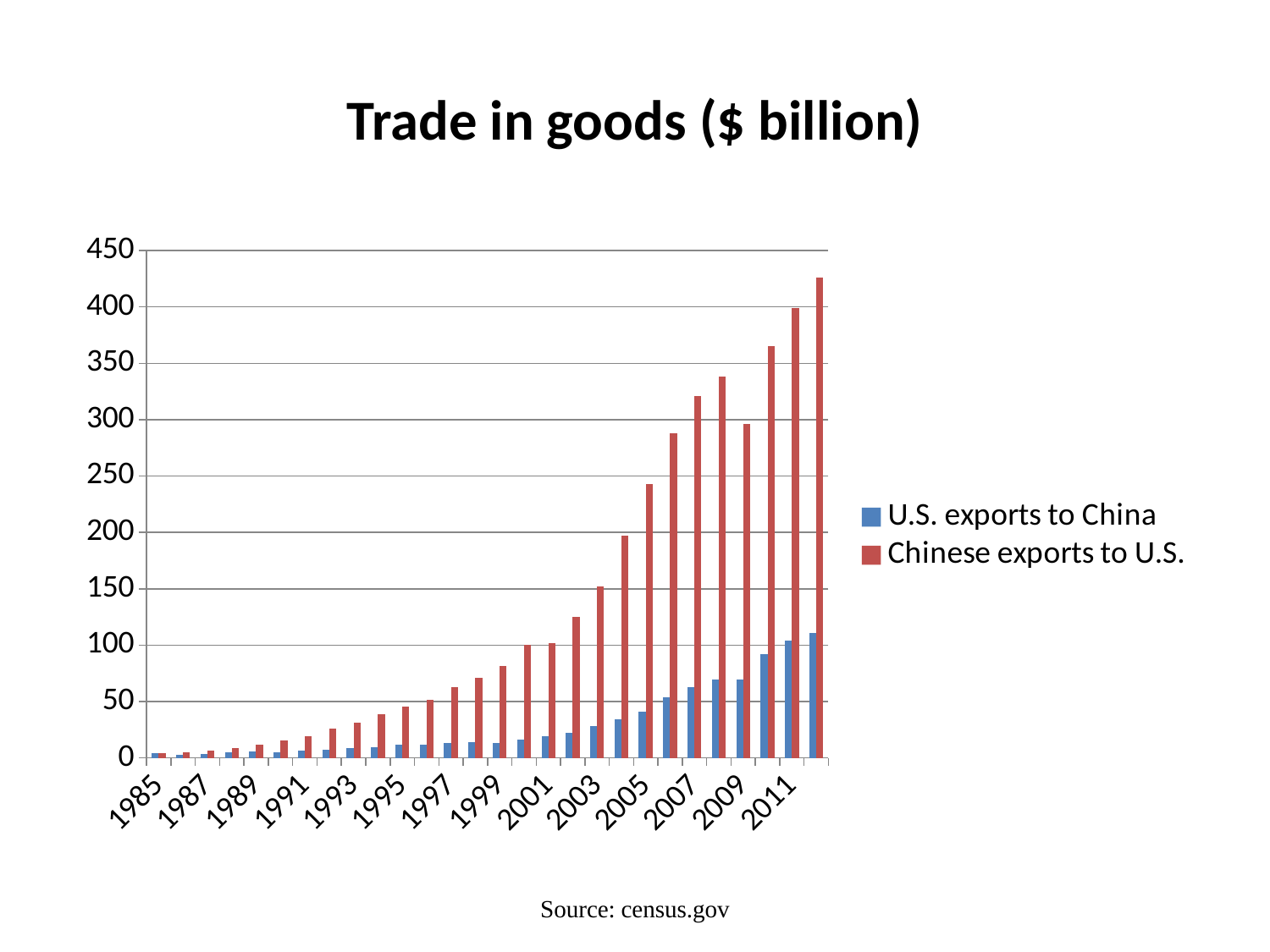
How many series does the legend list? 2 Is the value for U.S. exports to China in 2005 greater or less than 50? less How many year labels are shown on the x axis? 14 What is the title of the chart? Trade in goods ($ billion) Is the value for Chinese exports to U.S. in 2010 greater or less than 350? greater Is the value for Chinese exports to U.S. in 2007 greater or less than 300? greater Which series is shown in red? Chinese exports to U.S. In 2011, which series has the larger value, U.S. exports to China or Chinese exports to U.S.? Chinese exports to U.S. Do the values for Chinese exports to U.S. generally rise or fall from 1985 to 2011? rise What kind of chart is shown on the slide? bar chart